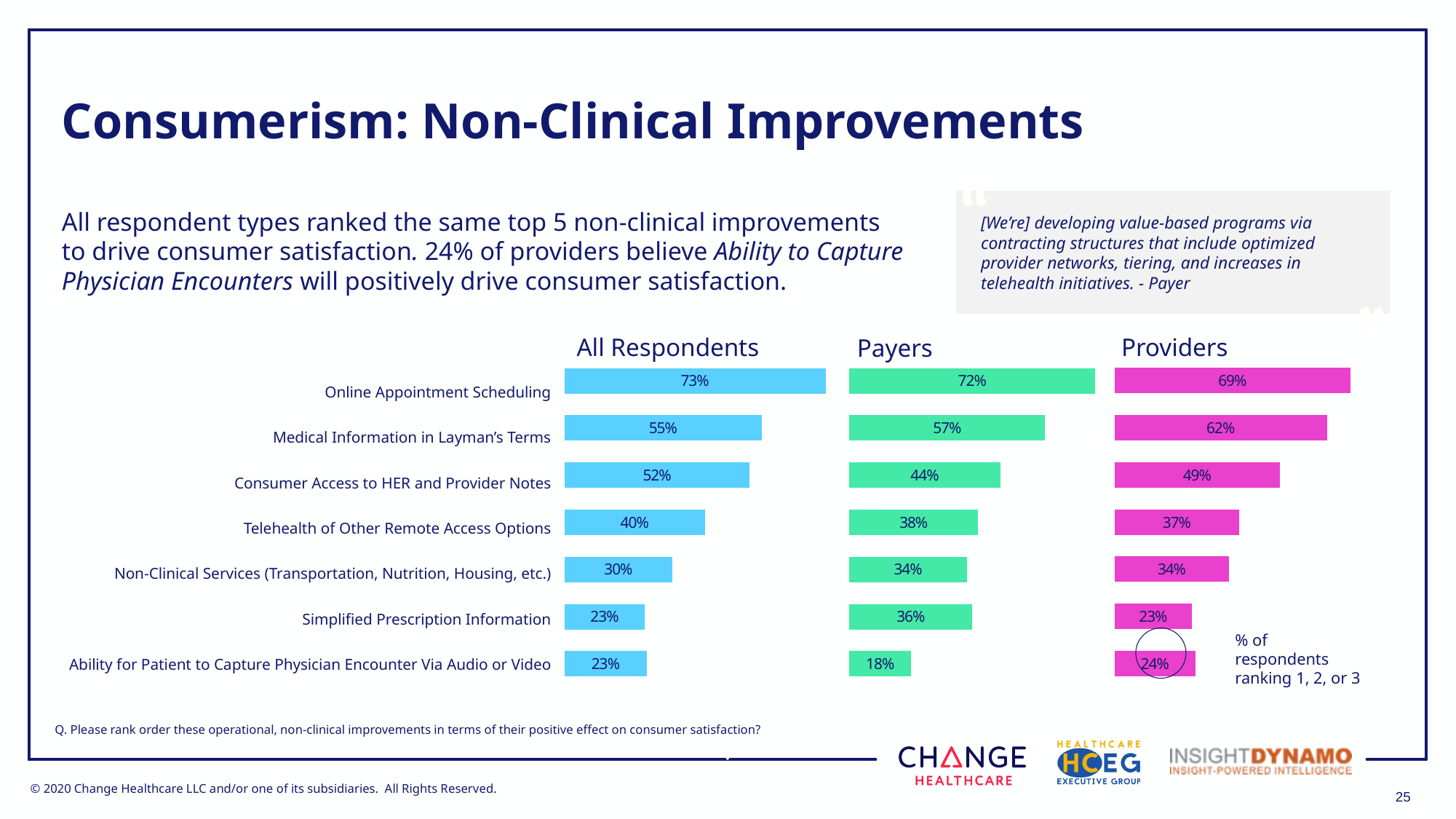
In the Providers chart, which category has the highest value? Online Appointment Scheduling What colour are the bars in the Payers chart? Green In the Providers chart, what is the value for Medical Information in Layman's Terms? 62% In the Payers chart, what is the difference between Simplified Prescription Information and Non-Clinical Services (Transportation, Nutrition, Housing, etc.)? 2% What kind of chart is the All Respondents chart? Bar chart In the Providers chart, what is the value for Ability for Patient to Capture Physician Encounter Via Audio or Video? 24% In the Payers chart, what is the value for Simplified Prescription Information? 36% In the All Respondents chart, what is the difference between Online Appointment Scheduling and Medical Information in Layman's Terms? 18% In the Payers chart, which is larger: Consumer Access to HER and Provider Notes or Telehealth of Other Remote Access Options? Consumer Access to HER and Provider Notes How many categories are shown in the Providers chart? 7 In the All Respondents chart, what is the value for Online Appointment Scheduling? 73% In the Payers chart, which category has the lowest value? Ability for Patient to Capture Physician Encounter Via Audio or Video